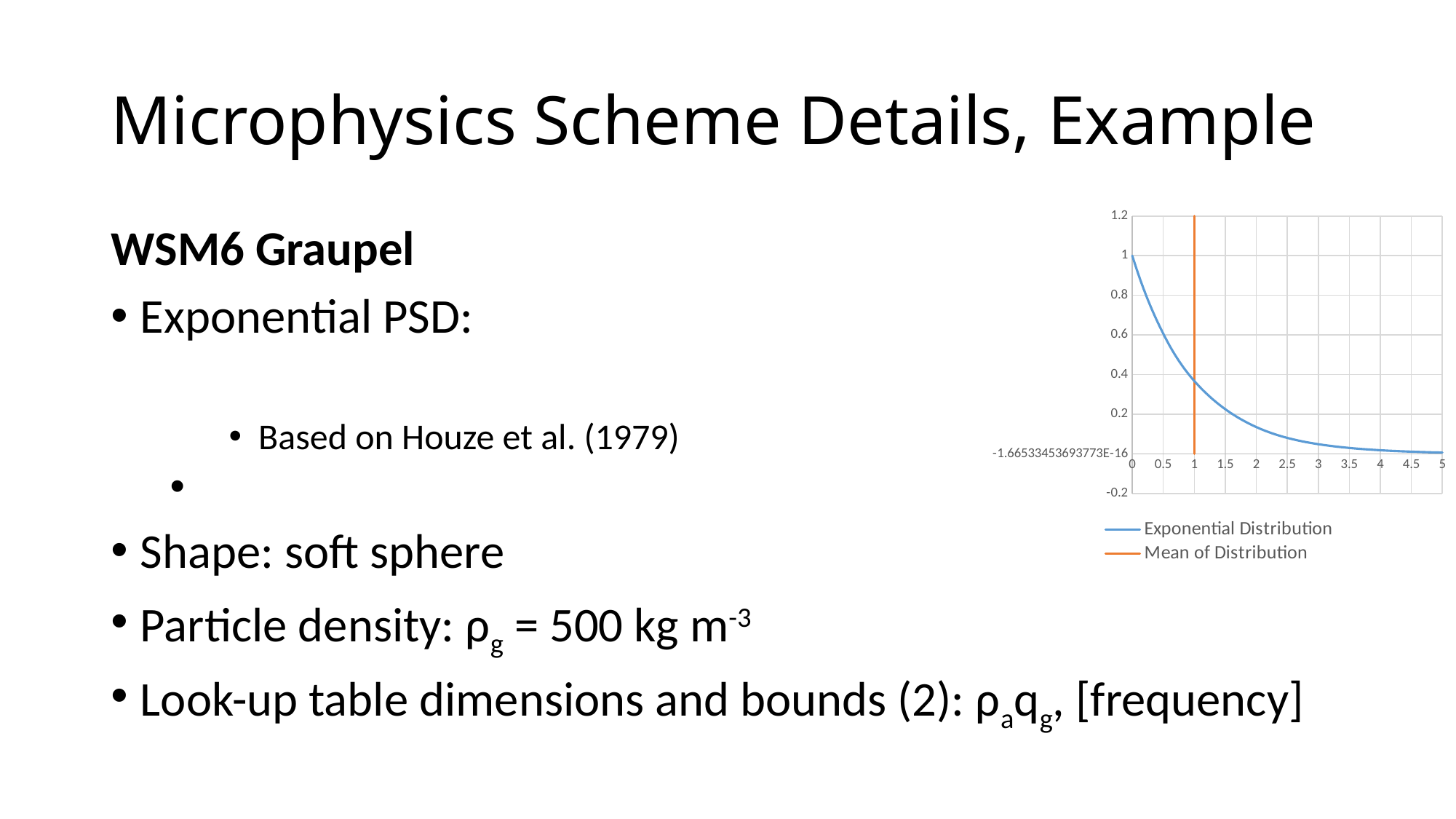
What is the largest x value labelled on the chart's x axis? 5 Is the value of the Exponential Distribution at x = 2 greater or less than 0.2? less What is the value of the Exponential Distribution at x = 0? 1 Is the value of the Exponential Distribution at x = 0.5 greater or less than 0.4? greater What are the two series named in the chart legend? Exponential Distribution; Mean of Distribution What is the highest value labelled on the chart's y axis? 1.2 At what x value is the Mean of Distribution vertical line drawn? 1 How many series does the chart legend list? 2 What kind of chart is shown on the slide? line chart Is the value of the Exponential Distribution at x = 1 greater or less than 0.2? greater How many tick labels are shown along the chart's x axis? 11 Does the Exponential Distribution curve rise or fall as x increases from 0 to 5? fall